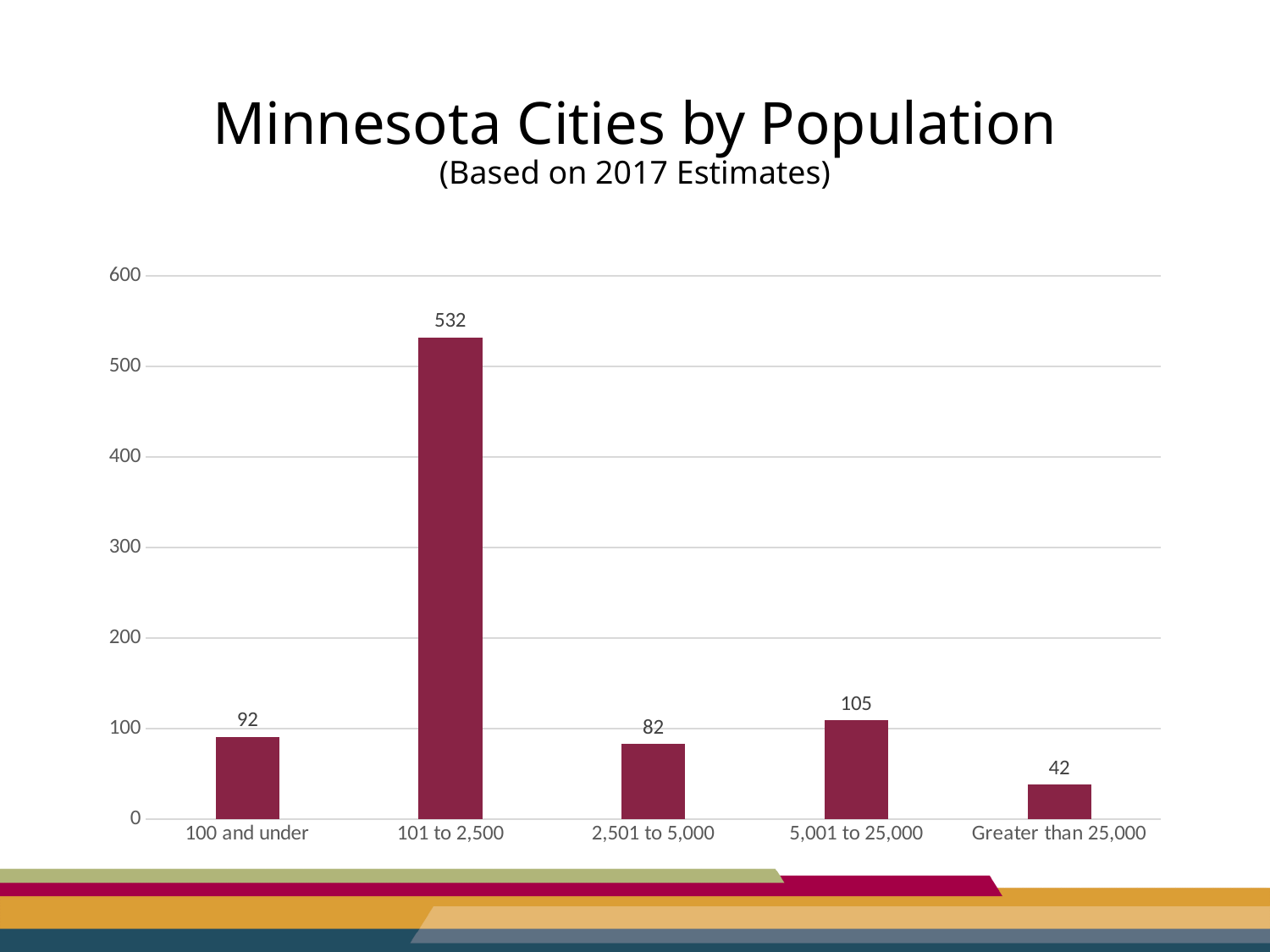
What is the value for the '100 and under' category? 92 What is the title of the chart? Minnesota Cities by Population (Based on 2017 Estimates) How many Minnesota cities have a population of 101 to 2,500? 532 Is the value for '2,501 to 5,000' greater or less than 100? less How many population categories are shown on the chart? 5 Which is larger, the value for '5,001 to 25,000' or the value for '100 and under'? 5,001 to 25,000 Which population category has the lowest number of cities? Greater than 25,000 What is the difference between the values for '101 to 2,500' and '5,001 to 25,000'? 427 What kind of chart is shown on the slide? bar chart What is the difference between the values for '100 and under' and '2,501 to 5,000'? 10 Which population category has the highest number of cities? 101 to 2,500 What is the value for the 'Greater than 25,000' category? 42